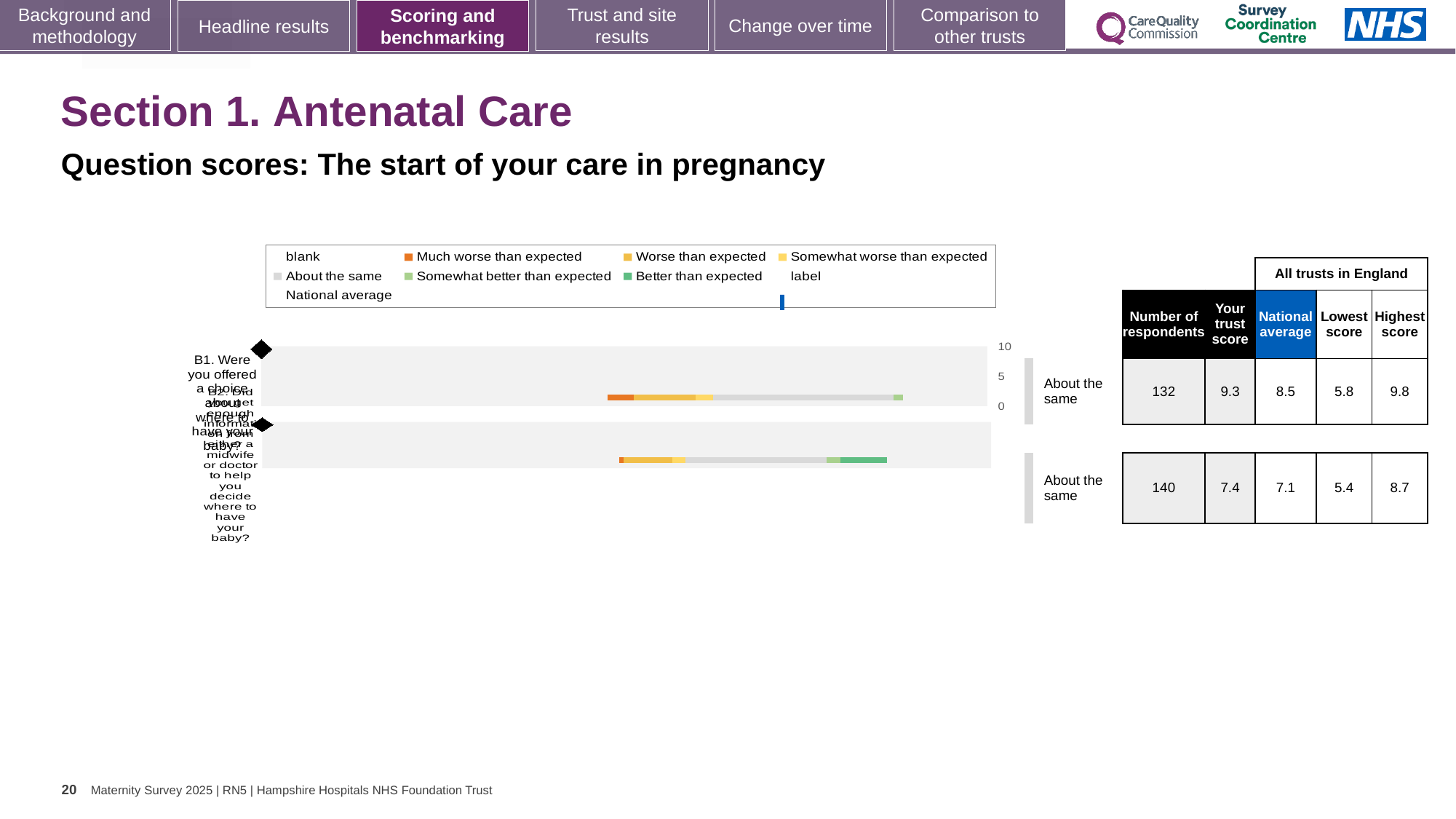
How many questions (categories) are plotted in the chart? 2 In the table next to the chart, what is the trust score for question B1? 9.3 Which legend entry is shown in orange? Much worse than expected In the table next to the chart, what is the lowest score for question B1? 5.8 What benchmark category is shown beside the bar for question B2? About the same In the table next to the chart, what is the number of respondents for question B1? 132 What is the highest value shown on the chart's axis? 10 What is the difference between the trust score and the national average for question B1 in the table? 0.8 Which question has the higher trust score in the table, B1 or B2? B1 In the table next to the chart, what is the national average for question B2? 7.1 What kind of chart is shown on the slide? bar chart In the table next to the chart, what is the highest score for question B2? 8.7